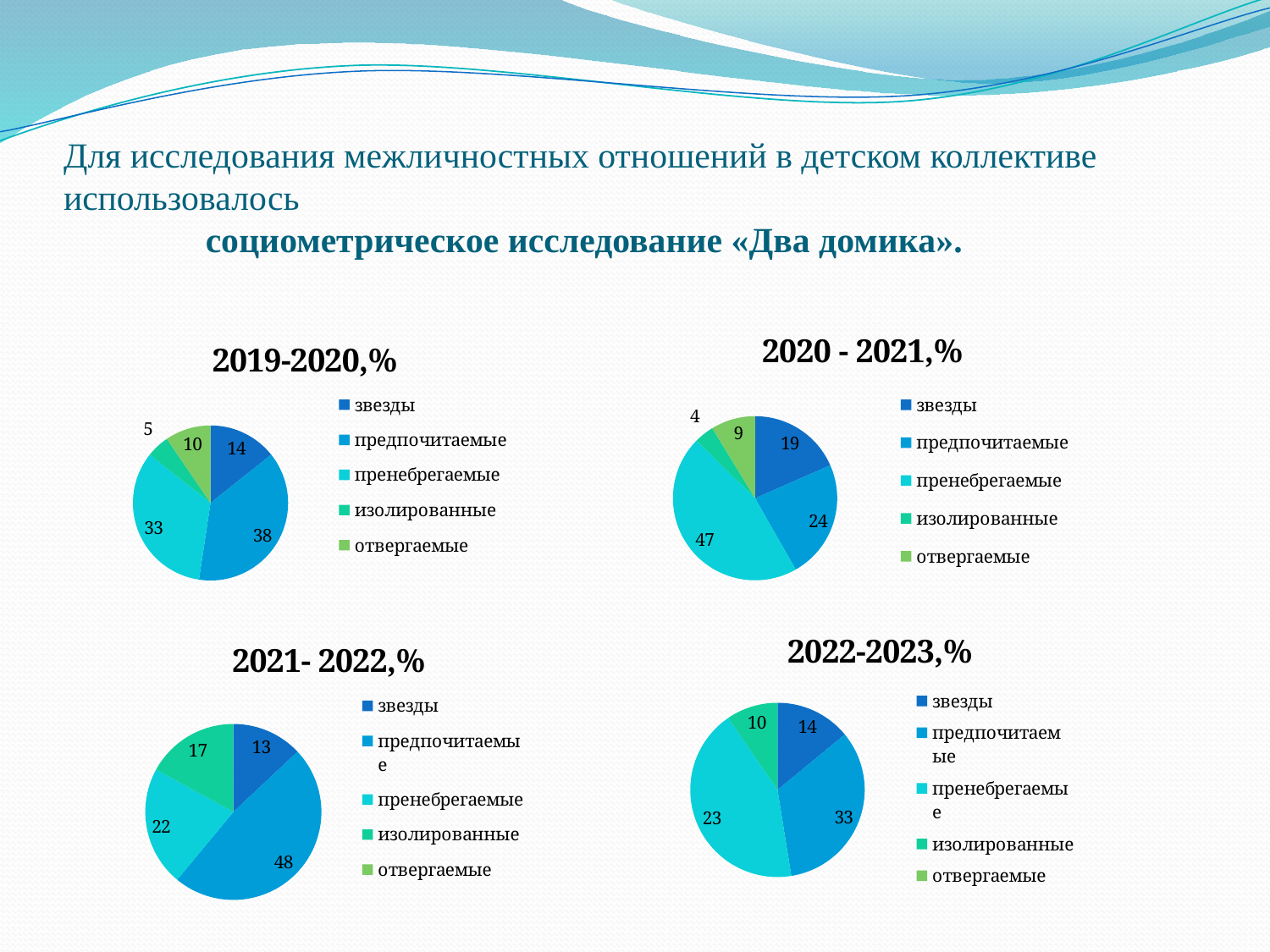
In the 2020 - 2021,% chart, which category has the smallest slice? изолированные In the 2019-2020,% chart, what is the difference between предпочитаемые and пренебрегаемые? 5 How many entries does the legend of the 2020 - 2021,% chart list? 5 In the 2021- 2022,% chart, which category has the largest slice? предпочитаемые In the 2019-2020,% chart, what is the value for предпочитаемые? 38 How many pie charts are shown on the slide? 4 In the 2022-2023,% chart, what is the value for пренебрегаемые? 23 What type of chart is the 2022-2023,% chart? pie chart In the 2019-2020,% chart, which category has the smallest slice? изолированные In the 2020 - 2021,% chart, which category has the largest slice? пренебрегаемые In the 2021- 2022,% chart, what is the value for изолированные? 17 In the 2020 - 2021,% chart, which is larger: звезды or предпочитаемые? предпочитаемые